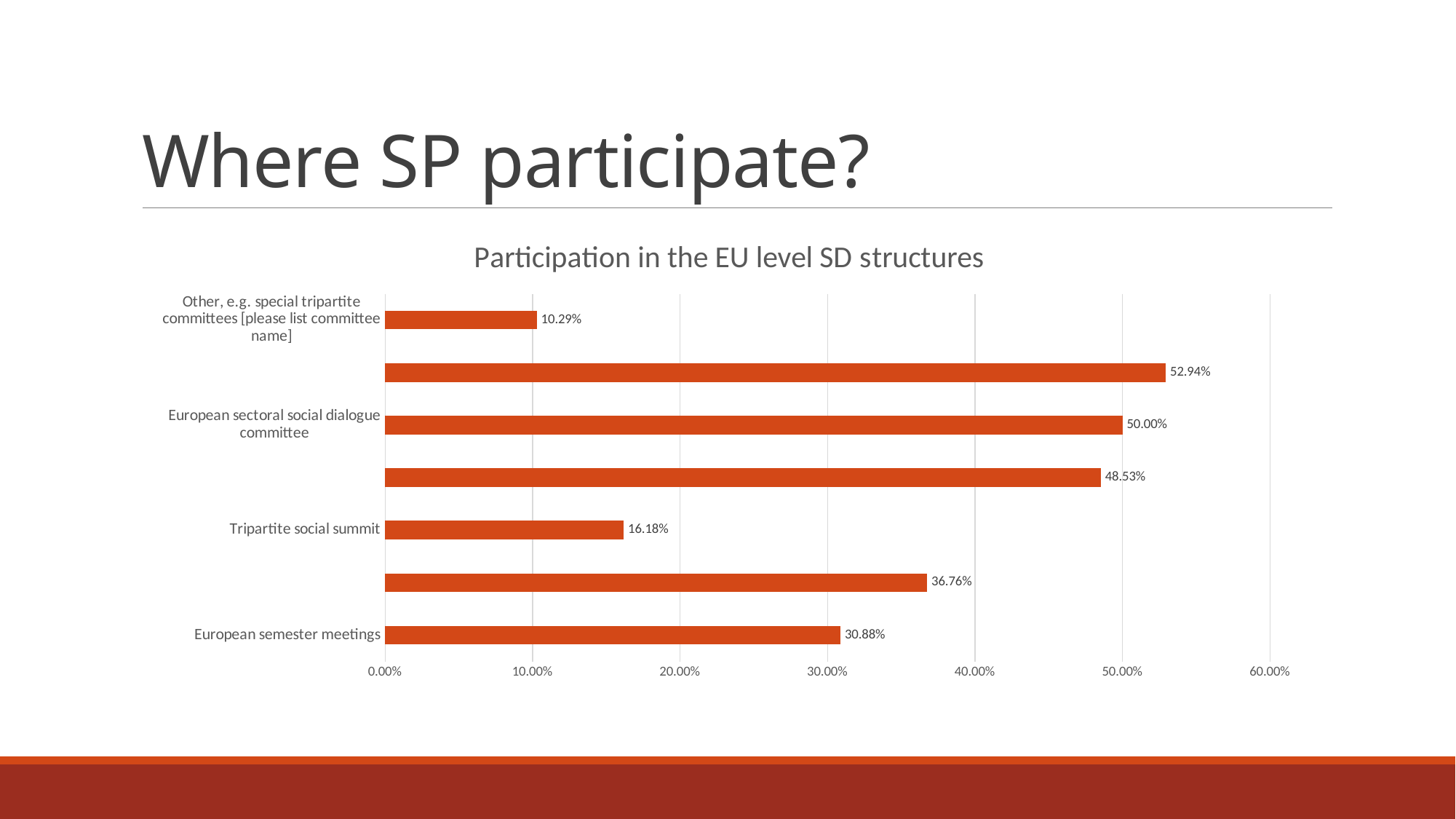
How many bars are plotted on the chart? 7 What is the value for Tripartite social summit? 16.18% What is the value for the category 'Other, e.g. special tripartite committees'? 10.29% What is the highest value shown on the chart? 52.94% What is the difference between the values for European semester meetings and Tripartite social summit? 14.70% What is the value for European semester meetings? 30.88% What is the value for European sectoral social dialogue committee? 50.00% What is the title of the chart? Participation in the EU level SD structures What is the difference between the values for European sectoral social dialogue committee and European semester meetings? 19.12% Which is larger: the value for European sectoral social dialogue committee or for Tripartite social summit? European sectoral social dialogue committee Which category has the lowest value? Other, e.g. special tripartite committees What kind of chart is shown? Bar chart